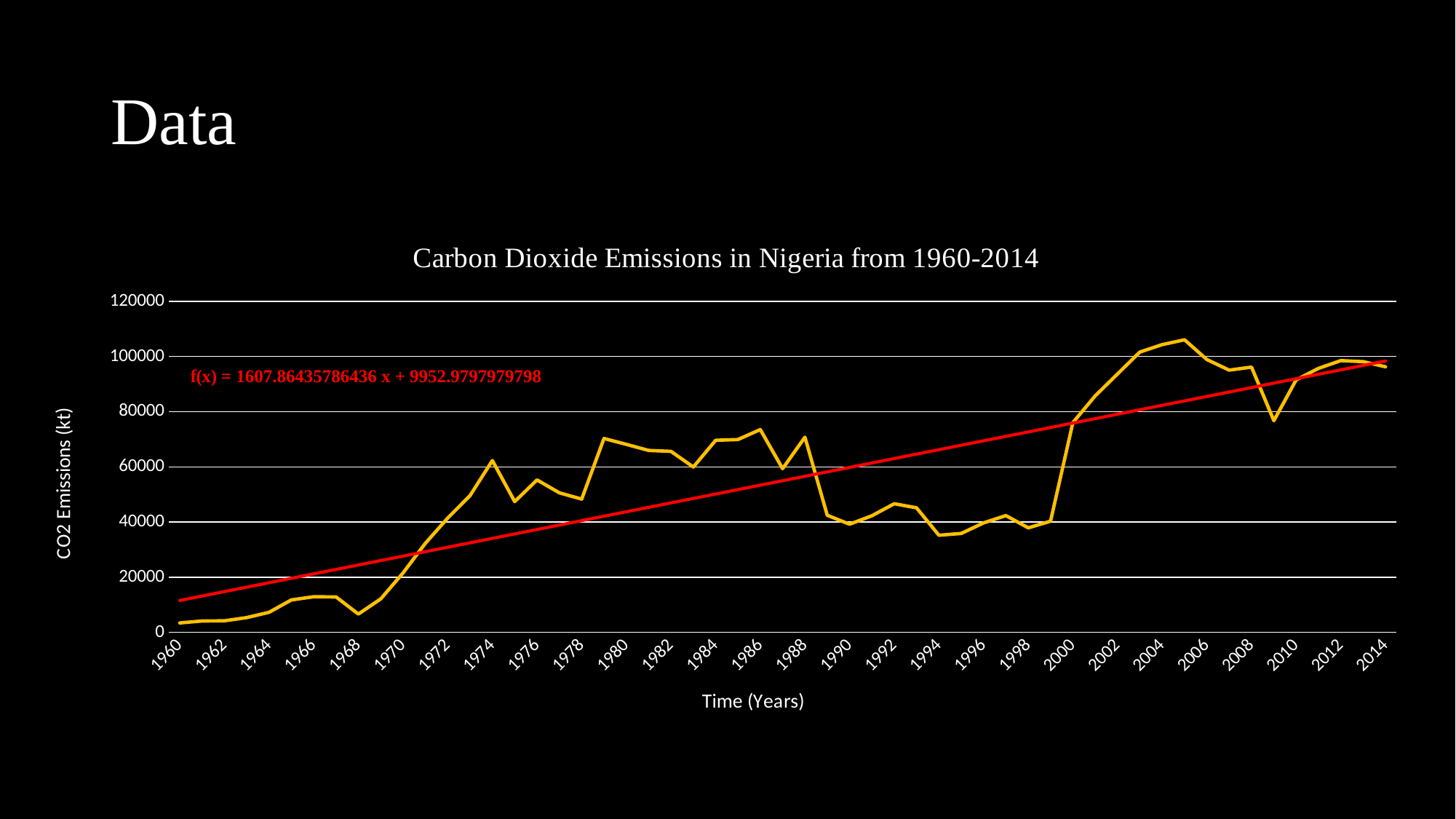
Is the value for 1986 greater or less than 60000? greater What kind of chart is shown on the slide? line chart Overall, do CO2 emissions rise or fall from 1960 to 2014? rise Is the value for 2009 greater or less than 60000? greater What is the label on the vertical axis of the chart? CO2 Emissions (kt) In which year are CO2 emissions lowest? 1960 Which year has higher CO2 emissions, 1990 or 2000? 2000 Is the value for 1994 greater or less than 40000? less In which year are CO2 emissions highest? 2005 What is the title of the chart? Carbon Dioxide Emissions in Nigeria from 1960-2014